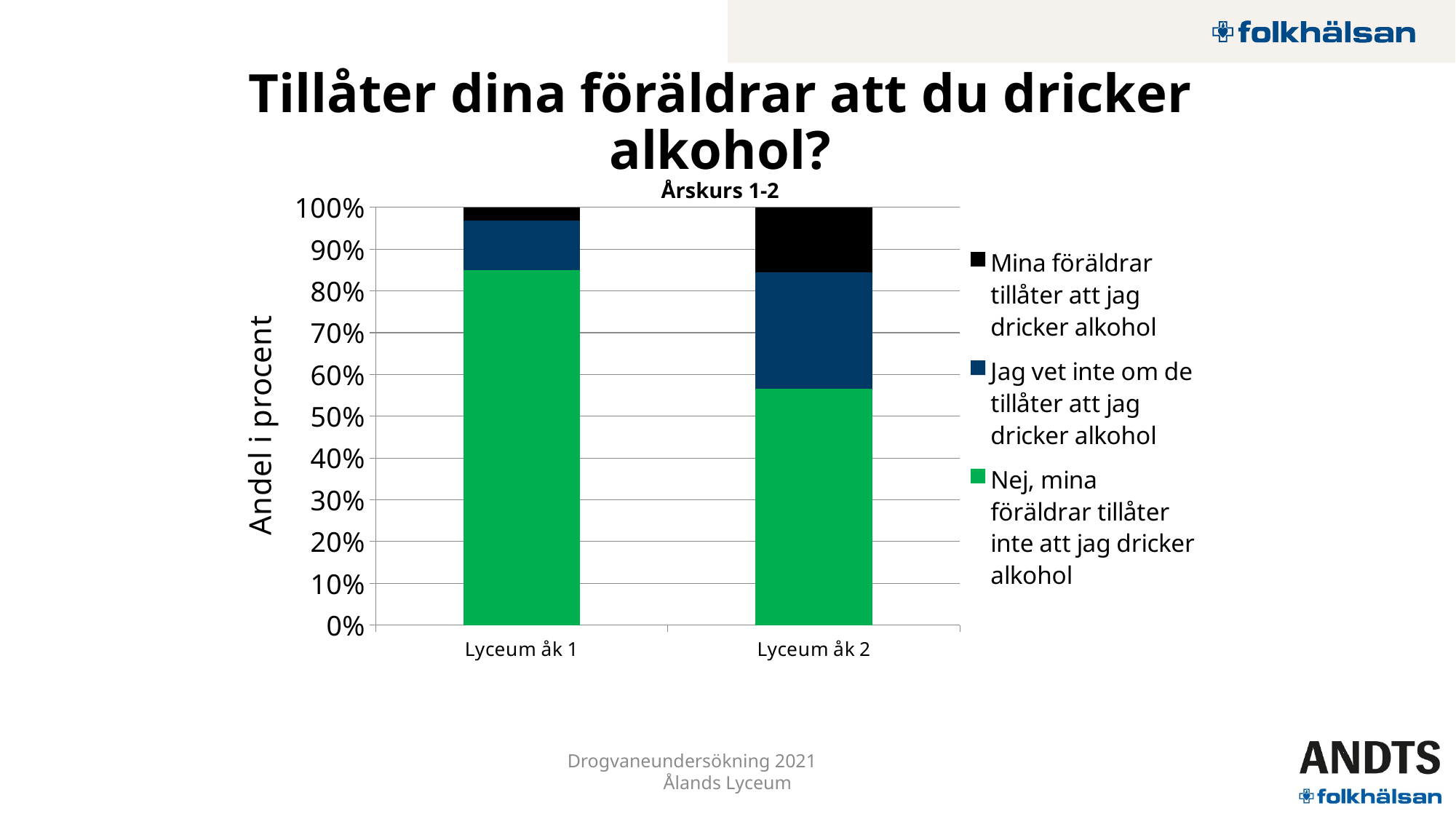
Does the share for "Nej, mina föräldrar tillåter inte att jag dricker alkohol" rise or fall from Lyceum åk 1 to Lyceum åk 2? fall Is the share for "Jag vet inte om de tillåter att jag dricker alkohol" for Lyceum åk 1 greater or less than 20%? less How many categories are shown on the x axis of the chart? 2 Which category has the larger share for "Nej, mina föräldrar tillåter inte att jag dricker alkohol", Lyceum åk 1 or Lyceum åk 2? Lyceum åk 1 Which category has the larger share for "Mina föräldrar tillåter att jag dricker alkohol", Lyceum åk 1 or Lyceum åk 2? Lyceum åk 2 Is the share for "Nej, mina föräldrar tillåter inte att jag dricker alkohol" for Lyceum åk 1 greater or less than 80%? greater What is the title printed above the chart? Årskurs 1-2 What kind of chart is shown on the slide? Stacked bar chart How many series does the chart's legend list? 3 Is the share for "Nej, mina föräldrar tillåter inte att jag dricker alkohol" for Lyceum åk 2 greater or less than 50%? greater What is the label of the vertical axis? Andel i procent